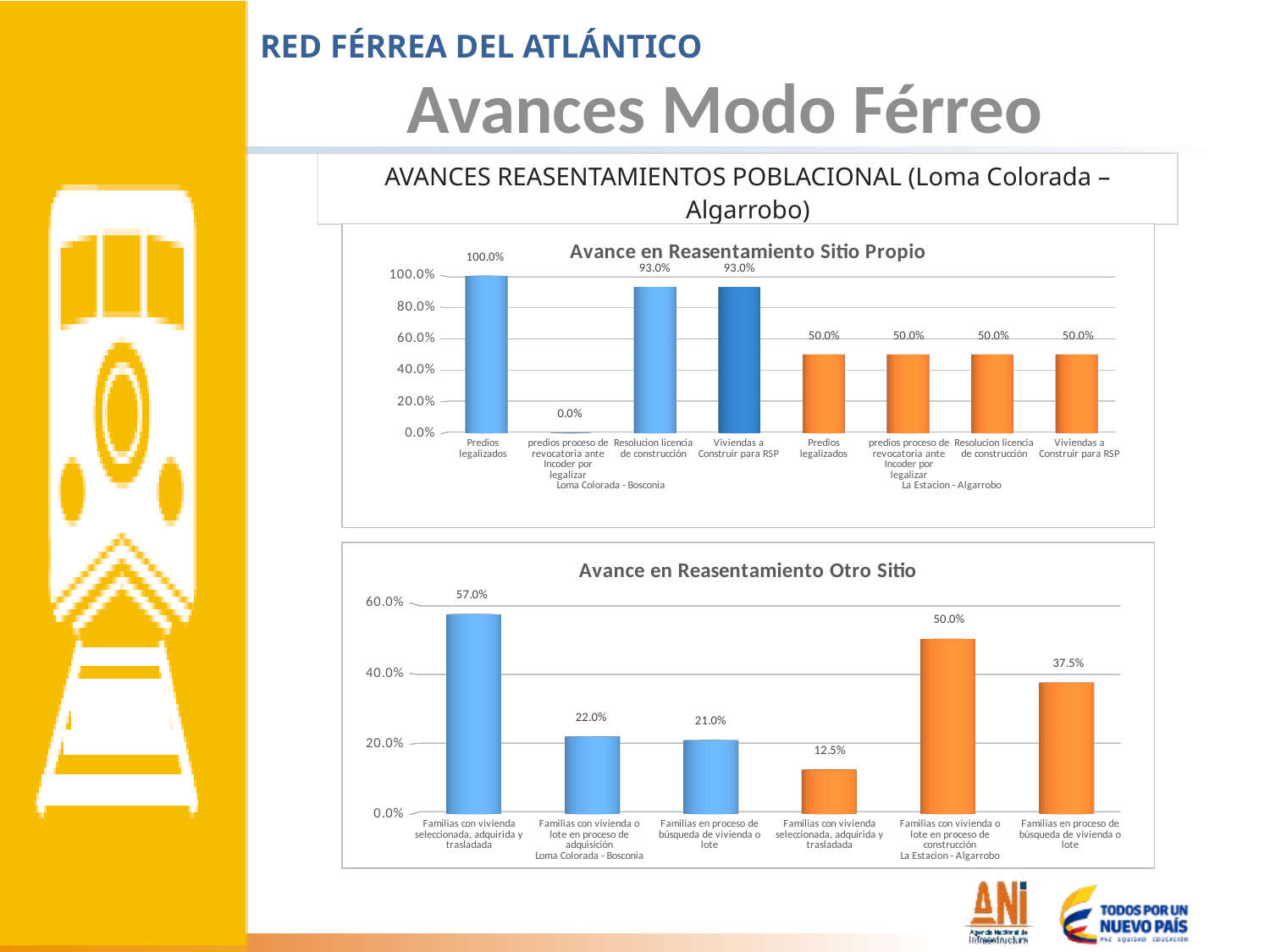
What type of chart is 'Avance en Reasentamiento Otro Sitio'? Bar chart In the 'Avance en Reasentamiento Sitio Propio' chart, what is the value for Resolucion licencia de construcción in Loma Colorada - Bosconia? 93.0% In the 'Avance en Reasentamiento Sitio Propio' chart, what is the value for Predios legalizados in Loma Colorada - Bosconia? 100.0% In the 'Avance en Reasentamiento Sitio Propio' chart, which category has the lowest value? predios proceso de revocatoria ante Incoder por legalizar (Loma Colorada - Bosconia) In the 'Avance en Reasentamiento Otro Sitio' chart, which is larger: Familias con vivienda o lote en proceso de construcción in La Estacion - Algarrobo or Familias con vivienda o lote en proceso de adquisición in Loma Colorada - Bosconia? Familias con vivienda o lote en proceso de construcción in La Estacion - Algarrobo In the 'Avance en Reasentamiento Sitio Propio' chart, what is the difference between Predios legalizados in Loma Colorada - Bosconia and Predios legalizados in La Estacion - Algarrobo? 50.0% In the 'Avance en Reasentamiento Otro Sitio' chart, what is the difference between the 57.0% bar and the 12.5% bar? 44.5% In the 'Avance en Reasentamiento Sitio Propio' chart, how many bars are plotted? 8 In the 'Avance en Reasentamiento Otro Sitio' chart, which category has the lowest value? Familias con vivienda seleccionada, adquirida y trasladada (La Estacion - Algarrobo) In the 'Avance en Reasentamiento Otro Sitio' chart, what is the value for Familias con vivienda seleccionada, adquirida y trasladada in Loma Colorada - Bosconia? 57.0% In the 'Avance en Reasentamiento Otro Sitio' chart, what is the value for Familias en proceso de búsqueda de vivienda o lote in La Estacion - Algarrobo? 37.5% In the 'Avance en Reasentamiento Sitio Propio' chart, what is the value for Viviendas a Construir para RSP in La Estacion - Algarrobo? 50.0%